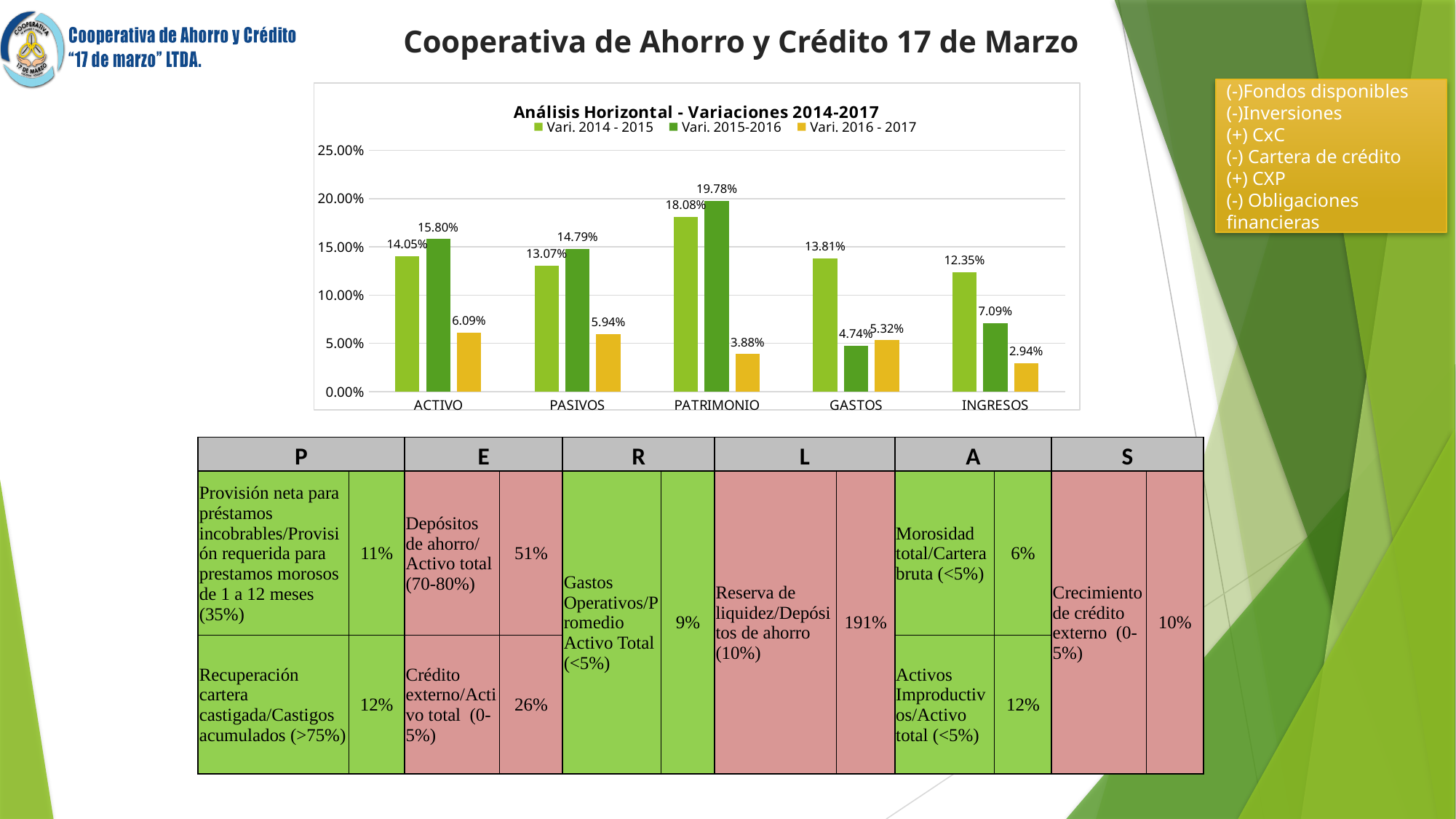
What is the value of Vari. 2014 - 2015 for GASTOS? 13.81% What is the difference between Vari. 2015-2016 and Vari. 2014 - 2015 for ACTIVO? 1.75% Is the value of Vari. 2015-2016 for PASIVOS greater or less than 10.00%? greater What is the value of Vari. 2016 - 2017 for INGRESOS? 2.94% Which category has the lowest value for Vari. 2016 - 2017? INGRESOS What is the value of Vari. 2016 - 2017 for ACTIVO? 6.09% How many categories are shown on the x axis of the chart? 5 Which category has the highest value for Vari. 2014 - 2015? PATRIMONIO What is the value of Vari. 2015-2016 for PATRIMONIO? 19.78% What type of chart is shown on the slide? Bar chart For GASTOS, which is larger: Vari. 2014 - 2015 or Vari. 2015-2016? Vari. 2014 - 2015 How many series does the chart legend list? 3